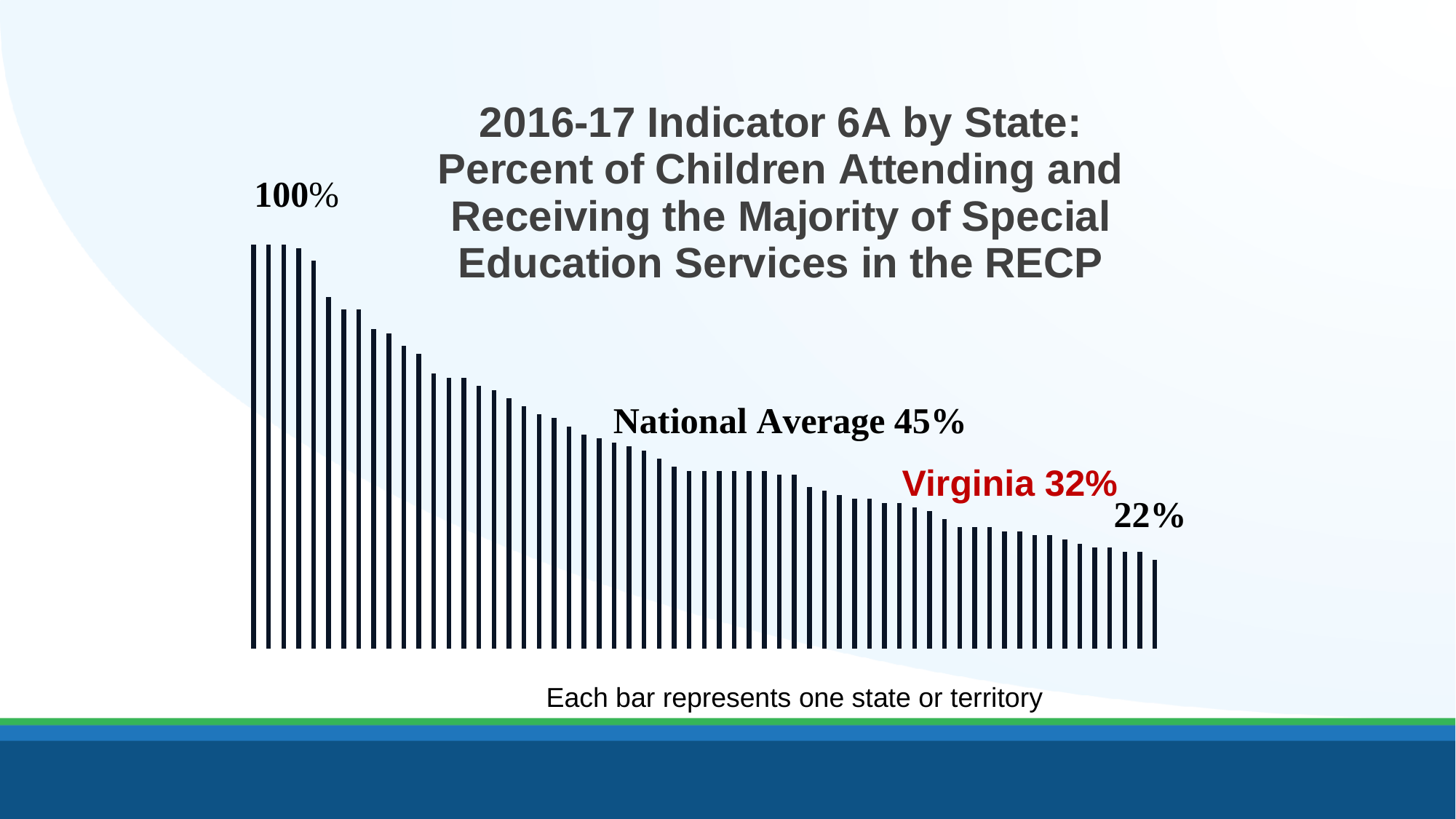
What is the value of the highest bar in the chart? 100% Which school year does the chart's title refer to? 2016-17 What kind of chart is shown on the slide? Bar chart What is the difference between the highest bar value and the lowest bar value? 78 percentage points What is the national average shown on the chart? 45% What is Virginia's value for Indicator 6A according to the chart? 32% Do the bar values rise or fall from left to right across the chart? Fall What is the difference between the national average and Virginia's value? 13 percentage points What does each bar in the chart represent? One state or territory What is the value of the lowest bar in the chart? 22% Is Virginia's value higher or lower than the national average? Lower